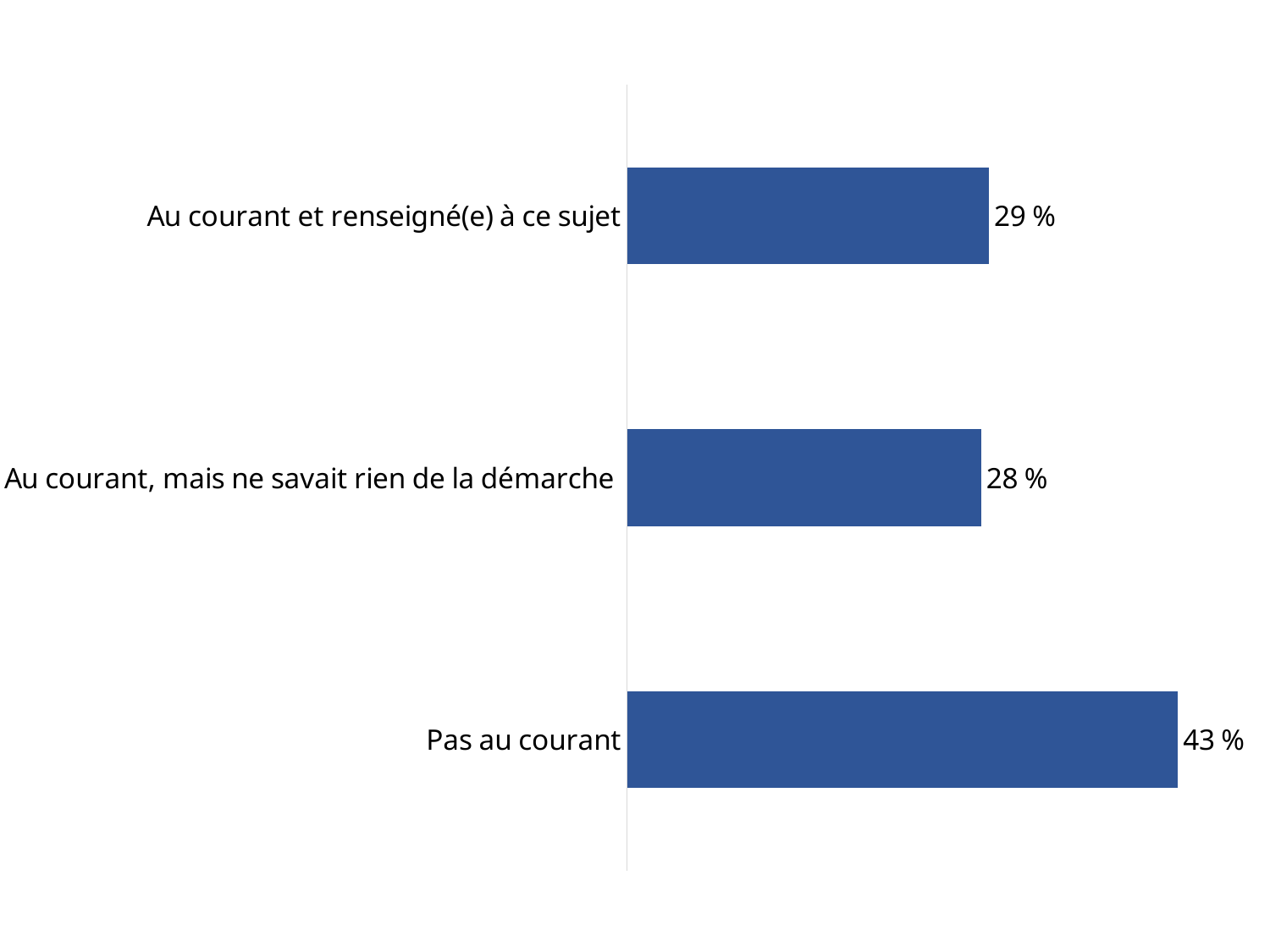
What is the value for "Au courant, mais ne savait rien de la démarche"? 28 % What is the value for "Pas au courant"? 43 % Which category has the highest value? Pas au courant What is the total of the three values shown in the chart? 100 % What is the value for "Au courant et renseigné(e) à ce sujet"? 29 % What colour are the bars in the chart? Blue Which is larger: the value for "Pas au courant" or the value for "Au courant, mais ne savait rien de la démarche"? Pas au courant What is the difference between the values for "Pas au courant" and "Au courant et renseigné(e) à ce sujet"? 14 % How many categories are shown in the chart? 3 What is the difference between the values for "Au courant et renseigné(e) à ce sujet" and "Au courant, mais ne savait rien de la démarche"? 1 % What kind of chart is shown on the slide? Bar chart